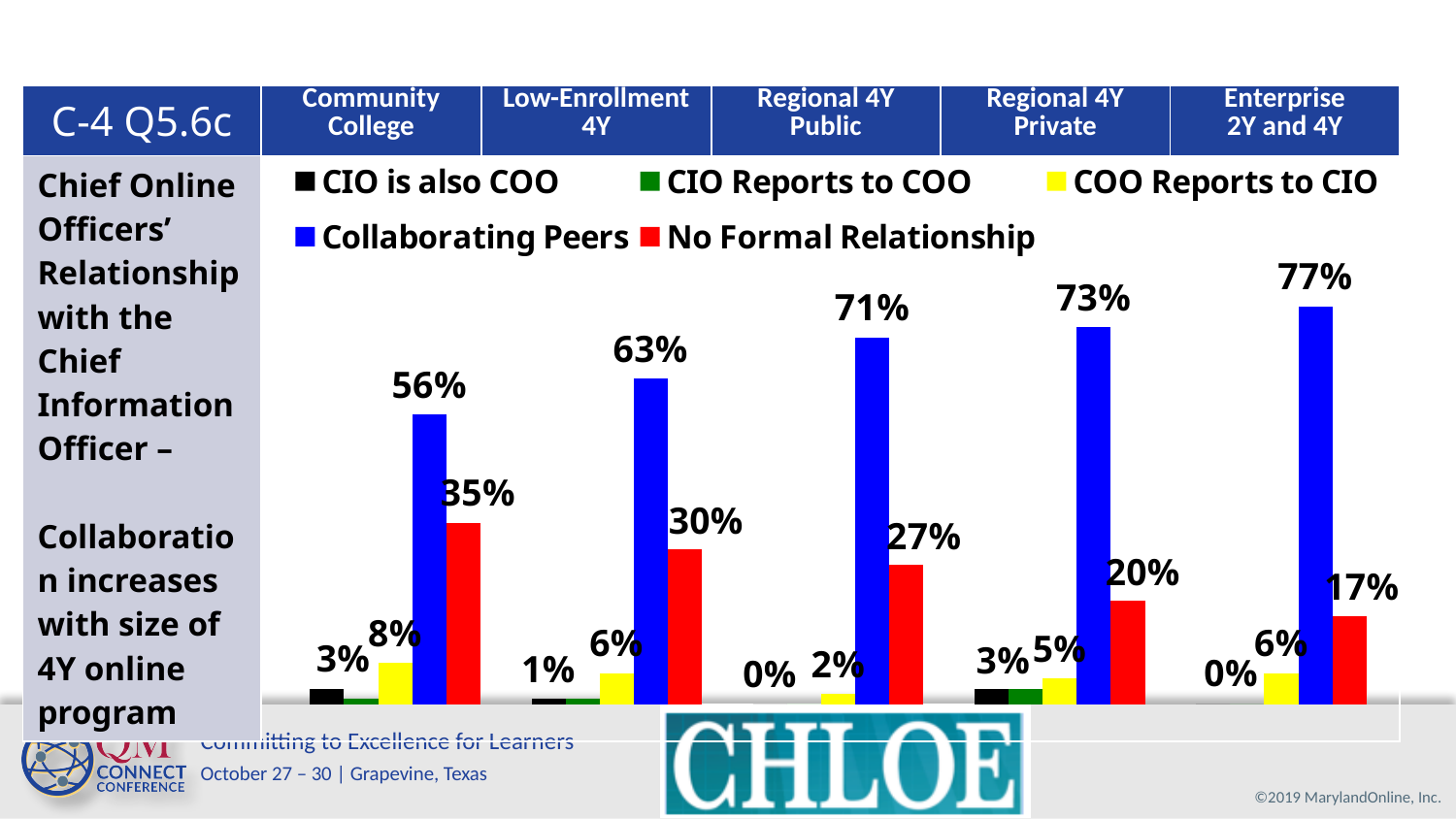
How many series does the legend list? 5 What is the Collaborating Peers value for Regional 4Y Public? 71% Which category has the lowest Collaborating Peers value? Community College Which category has the highest Collaborating Peers value? Enterprise 2Y and 4Y What kind of chart is shown on the slide? Bar chart How many institution categories are shown in the chart? 5 What is the Collaborating Peers value for Enterprise 2Y and 4Y? 77% Do the Collaborating Peers values rise or fall moving from Community College to Enterprise 2Y and 4Y? Rise Which category has the lowest No Formal Relationship value? Enterprise 2Y and 4Y Which is larger: the No Formal Relationship value for Low-Enrollment 4Y or for Regional 4Y Private? Low-Enrollment 4Y What is the difference between the Collaborating Peers values for Enterprise 2Y and 4Y and Community College? 21 percentage points What is the No Formal Relationship value for Community College? 35%